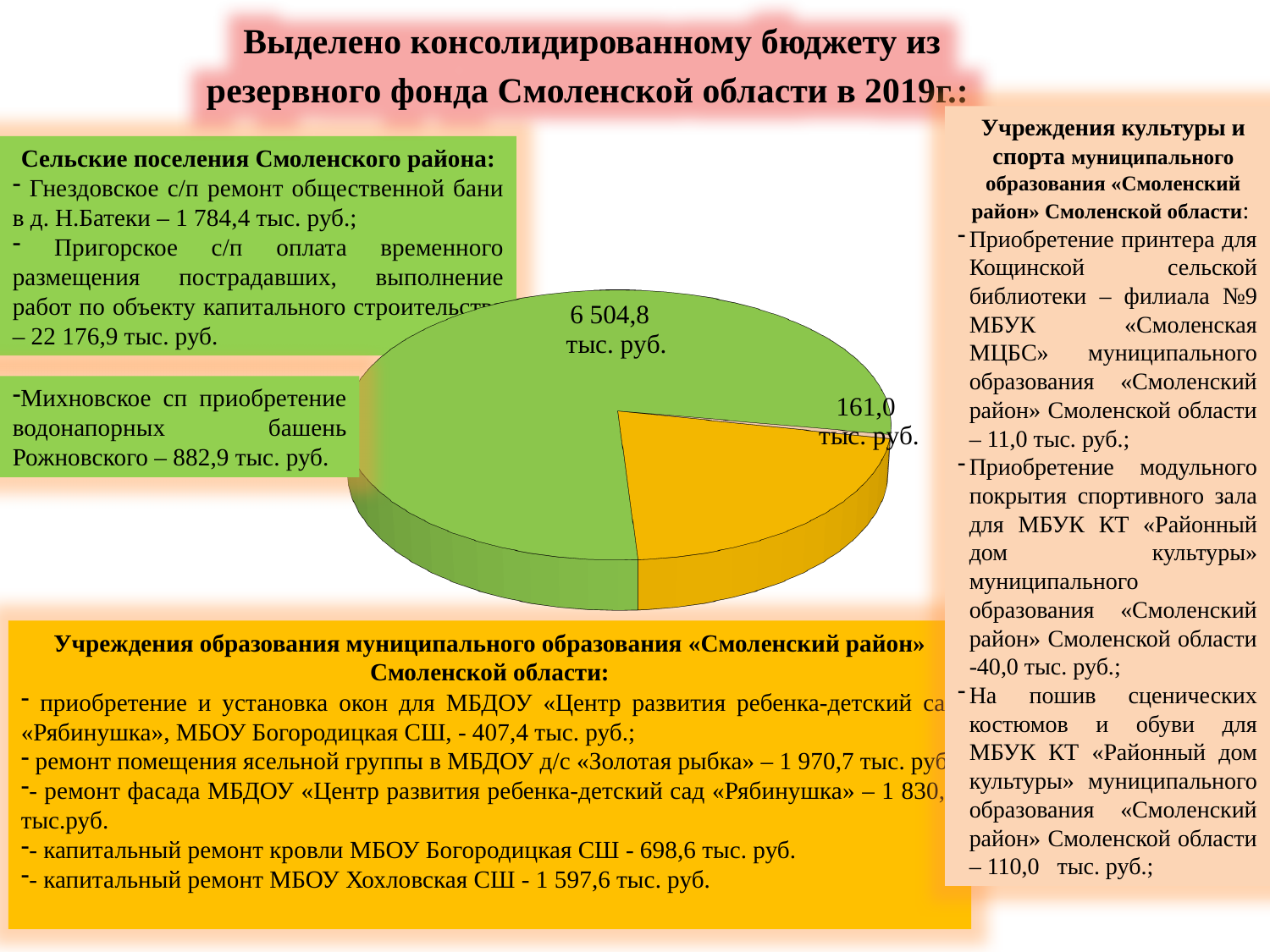
Which colour slice is the largest in the pie chart? green Which is larger, the value labelled 6 504,8 тыс. руб. or the value labelled 161,0 тыс. руб.? 6 504,8 тыс. руб. How many slices does the pie chart have? 3 Is the value 161,0 тыс. руб. on the pie chart greater or less than 1 000 тыс. руб.? less What is the difference between the two values printed on the pie chart, 6 504,8 and 161,0 тыс. руб.? 6 343,8 тыс. руб. What is the larger of the two values printed on the pie chart? 6 504,8 тыс. руб. What kind of chart is shown on the slide? pie chart What is the smaller of the two values printed on the pie chart? 161,0 тыс. руб. Does the pie chart have a legend? No Is the value 6 504,8 тыс. руб. on the pie chart greater or less than 5 000 тыс. руб.? greater How many data labels are printed on the pie chart? 2 What is the title at the top of the slide? Выделено консолидированному бюджету из резервного фонда Смоленской области в 2019г.